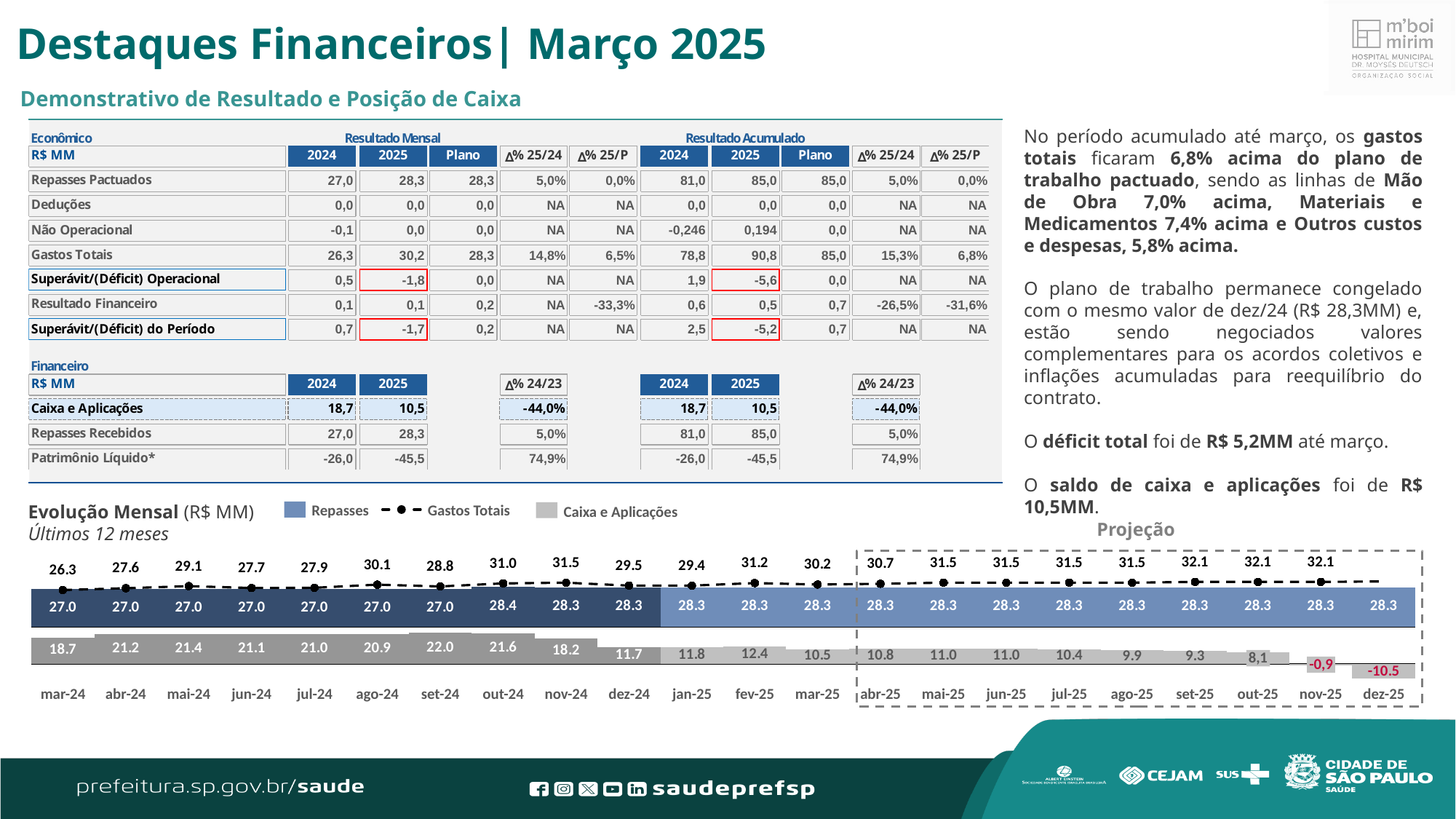
In the Evolução Mensal chart, which month has the highest value for Caixa e Aplicações? set-24 In the Evolução Mensal chart, which month has the higher Gastos Totais value, mai-24 or jun-24? mai-24 In the Evolução Mensal chart, which month has the lowest value for Caixa e Aplicações? dez-25 In the Evolução Mensal chart, what is the value of Repasses for out-24? 28.4 In the Evolução Mensal chart, what is the value of Caixa e Aplicações for nov-25? -0,9 In the Evolução Mensal chart, what is the value of Caixa e Aplicações for mar-25? 10.5 In the Evolução Mensal chart, do the Caixa e Aplicações values rise or fall from mar-25 to dez-25? Fall How many months are shown on the x axis of the Evolução Mensal chart? 22 In the Evolução Mensal chart, what is the value of Gastos Totais for out-24? 31.0 What kind of chart is the Evolução Mensal chart? Bar and line chart In the Evolução Mensal chart, what is the difference between Gastos Totais in nov-24 and in mar-24? 5.2 How many series does the legend of the Evolução Mensal chart list? 3